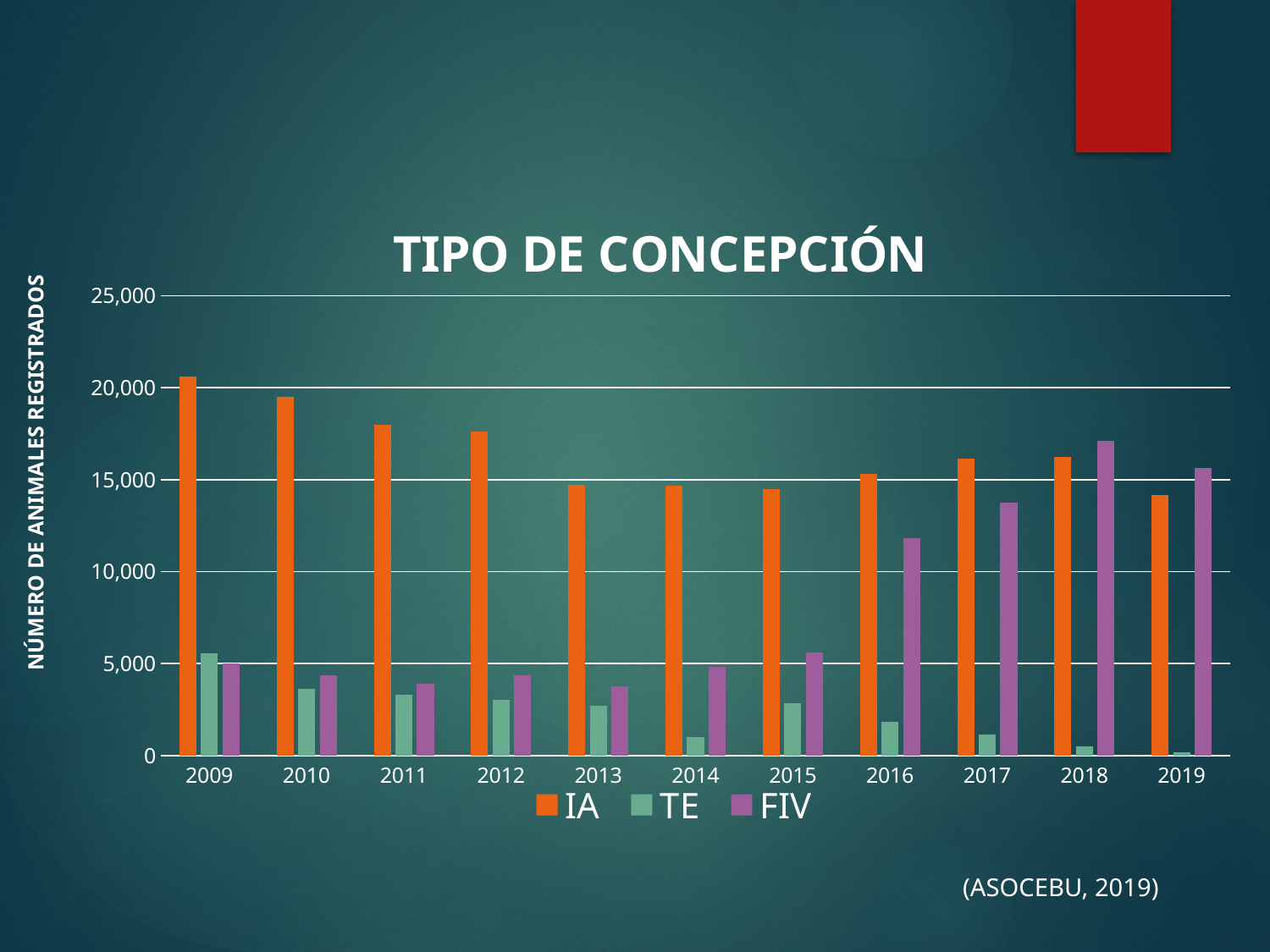
Do the TE values rise or fall from 2009 to 2019? Fall In 2015, which is larger, the TE value or the FIV value? FIV How many series does the legend list? 3 How many years are shown on the x axis? 11 In 2018, which is larger, the IA value or the FIV value? FIV Is the IA value for 2009 greater or less than 20,000? greater Is the FIV value for 2016 greater or less than 10,000? greater In which year is the IA value highest? 2009 What kind of chart is shown on the slide? Bar chart What is the title of the chart? TIPO DE CONCEPCIÓN In which year is the FIV value highest? 2018 In which year is the TE value lowest? 2019